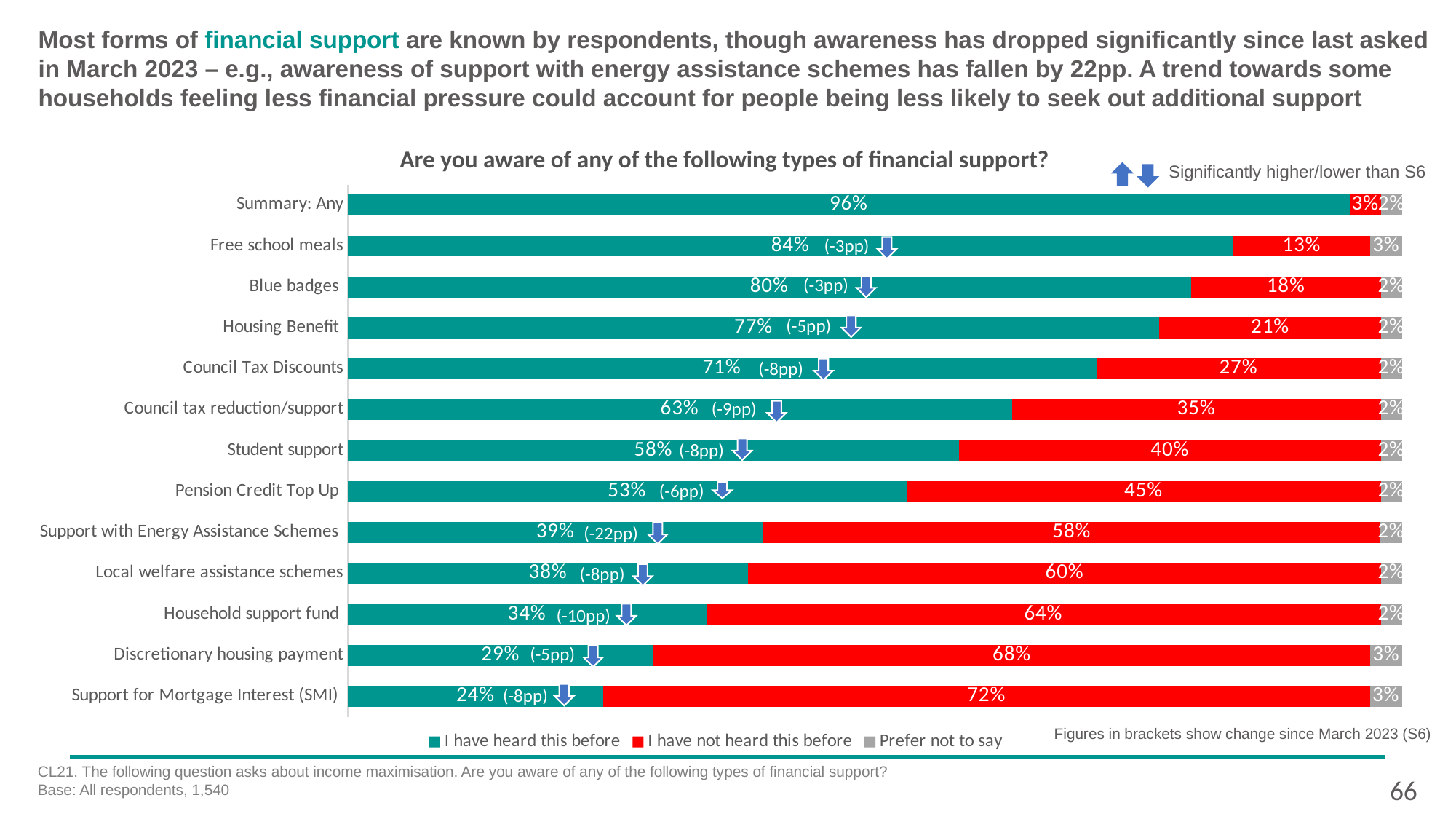
How many series does the legend list? 3 What is the difference between the 'I have heard this before' values for Housing Benefit and Student support? 19 percentage points What percentage of respondents have heard of Free school meals before? 84% What is the title of the chart? Are you aware of any of the following types of financial support? What change since March 2023 is shown in brackets for Support with Energy Assistance Schemes? -22pp Which type of financial support has the lowest 'I have heard this before' value? Support for Mortgage Interest (SMI) Which has a larger 'I have not heard this before' value: Council Tax Discounts or Pension Credit Top Up? Pension Credit Top Up How many types of financial support (category rows) are shown in the chart? 13 Excluding the 'Summary: Any' row, which type of financial support has the highest 'I have heard this before' value? Free school meals What kind of chart is shown on the slide? Stacked bar chart What percentage of respondents have not heard of Support with Energy Assistance Schemes before? 58% What is the 'Prefer not to say' value for Discretionary housing payment? 3%